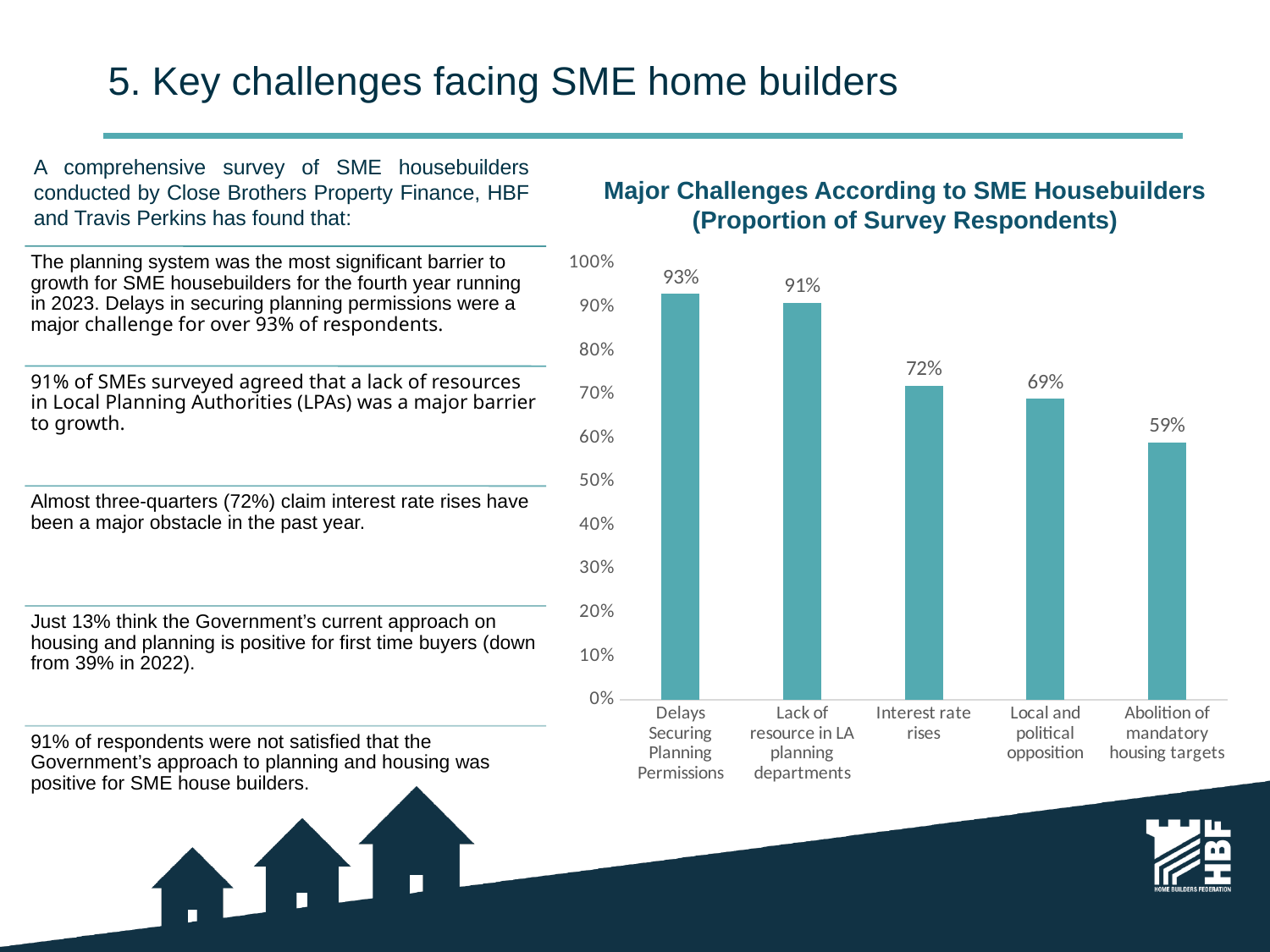
Which challenge has the highest proportion of survey respondents? Delays Securing Planning Permissions What is the value for Abolition of mandatory housing targets? 59% What is the difference between the values for Interest rate rises and Local and political opposition? 3% What is the value for Interest rate rises? 72% How many challenges are shown on the chart? 5 What is the title of the chart? Major Challenges According to SME Housebuilders (Proportion of Survey Respondents) What kind of chart is shown on the slide? Bar chart What is the value for Lack of resource in LA planning departments? 91% What proportion of survey respondents cited Delays Securing Planning Permissions as a major challenge? 93% Which is larger: the value for Local and political opposition or the value for Abolition of mandatory housing targets? Local and political opposition Which challenge has the lowest proportion of survey respondents? Abolition of mandatory housing targets Is the value for Interest rate rises greater or less than 80%? less